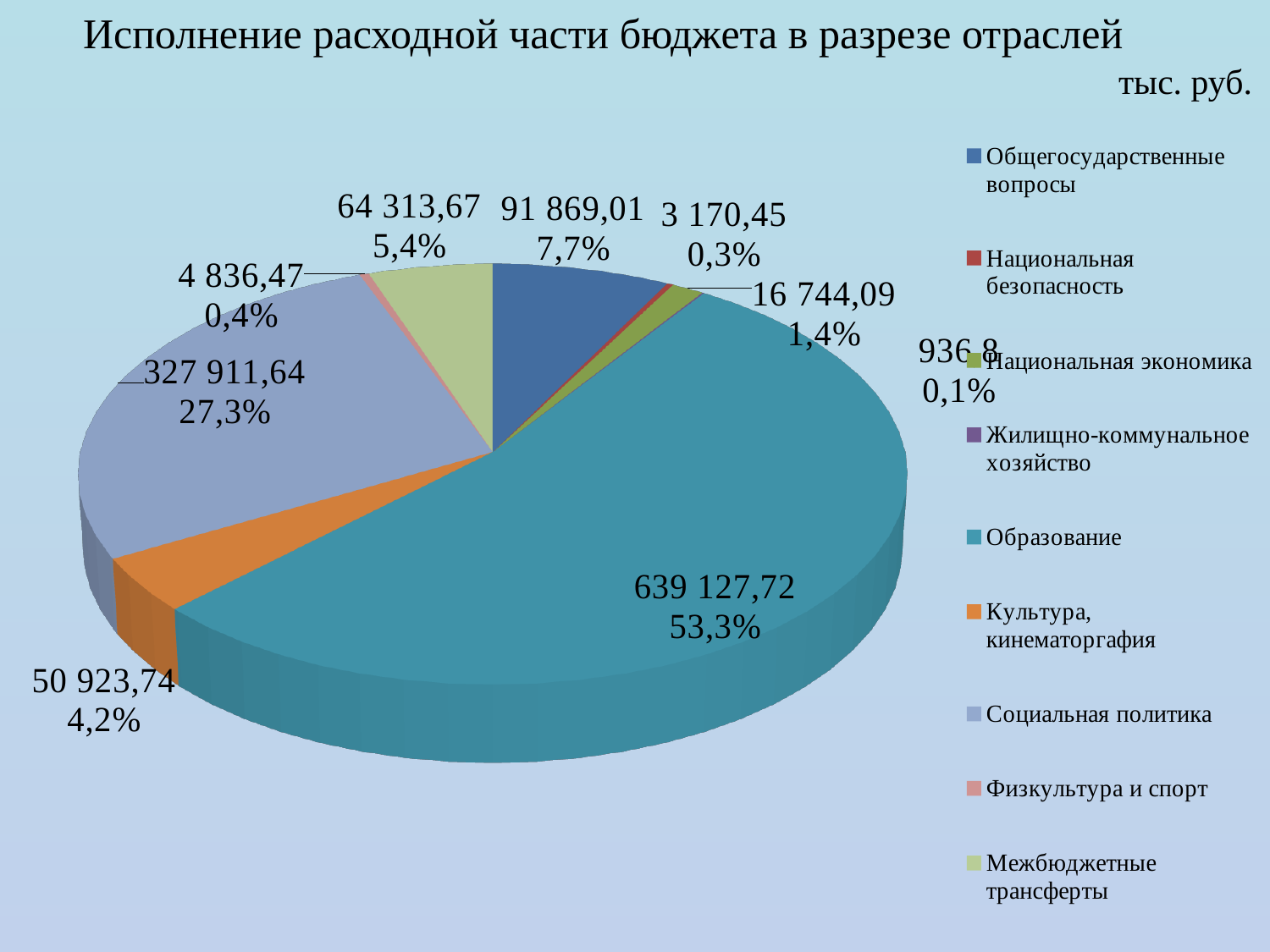
What kind of chart is shown on the slide? pie chart Which category has the largest slice of the pie? Образование What is the value for Общегосударственные вопросы? 91 869,01 What unit is stated for the values in the chart? тыс. руб. What is the value for Социальная политика? 327 911,64 What is the difference between the values for Образование and Социальная политика? 311 216,08 What share of the pie does Образование take? 53,3% How many categories does the legend of the pie chart list? 9 What share of the pie does Социальная политика take? 27,3% Which category has the smallest slice of the pie? Жилищно-коммунальное хозяйство What is the value for Образование? 639 127,72 Which is larger, the value for Межбюджетные трансферты or the value for Культура, кинематоргафия? Межбюджетные трансферты